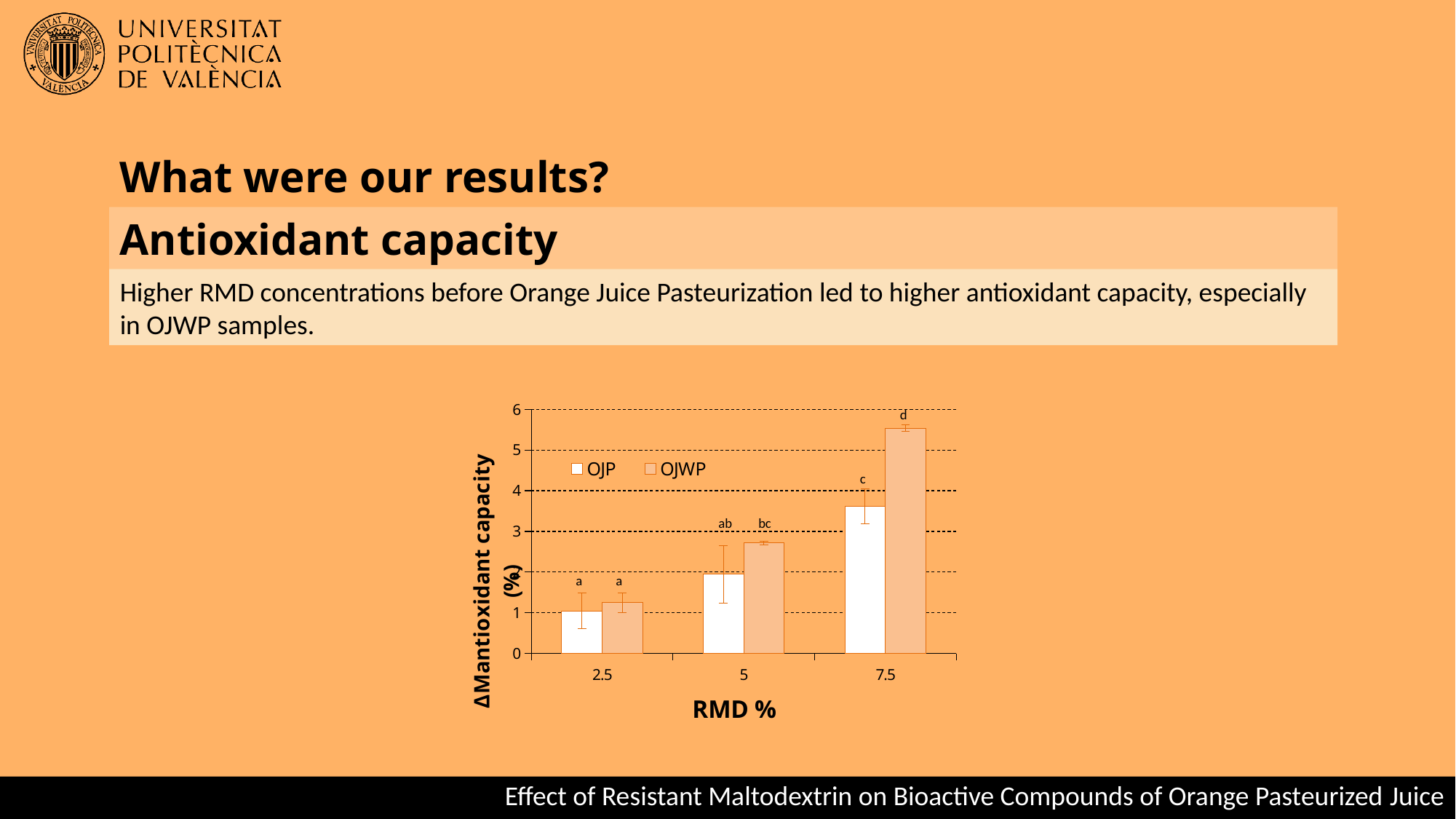
Is the value for OJP at RMD 7.5 greater or less than 3? greater Which bar in the chart is the highest? OJWP at 7.5 Do the OJWP values rise or fall as RMD % increases from 2.5 to 7.5? rise Is the value for OJWP at RMD 5 greater or less than 3? less Is the value for OJWP at RMD 7.5 greater or less than 5? greater How many series does the chart legend list? 2 What kind of chart is shown on the slide? bar chart What is the title of the x axis of the chart? RMD % Which bar in the chart is the lowest? OJP at 2.5 How many RMD % categories are shown on the x axis of the chart? 3 At RMD 7.5, which series has the larger value, OJP or OJWP? OJWP What are the two series named in the chart legend? OJP and OJWP